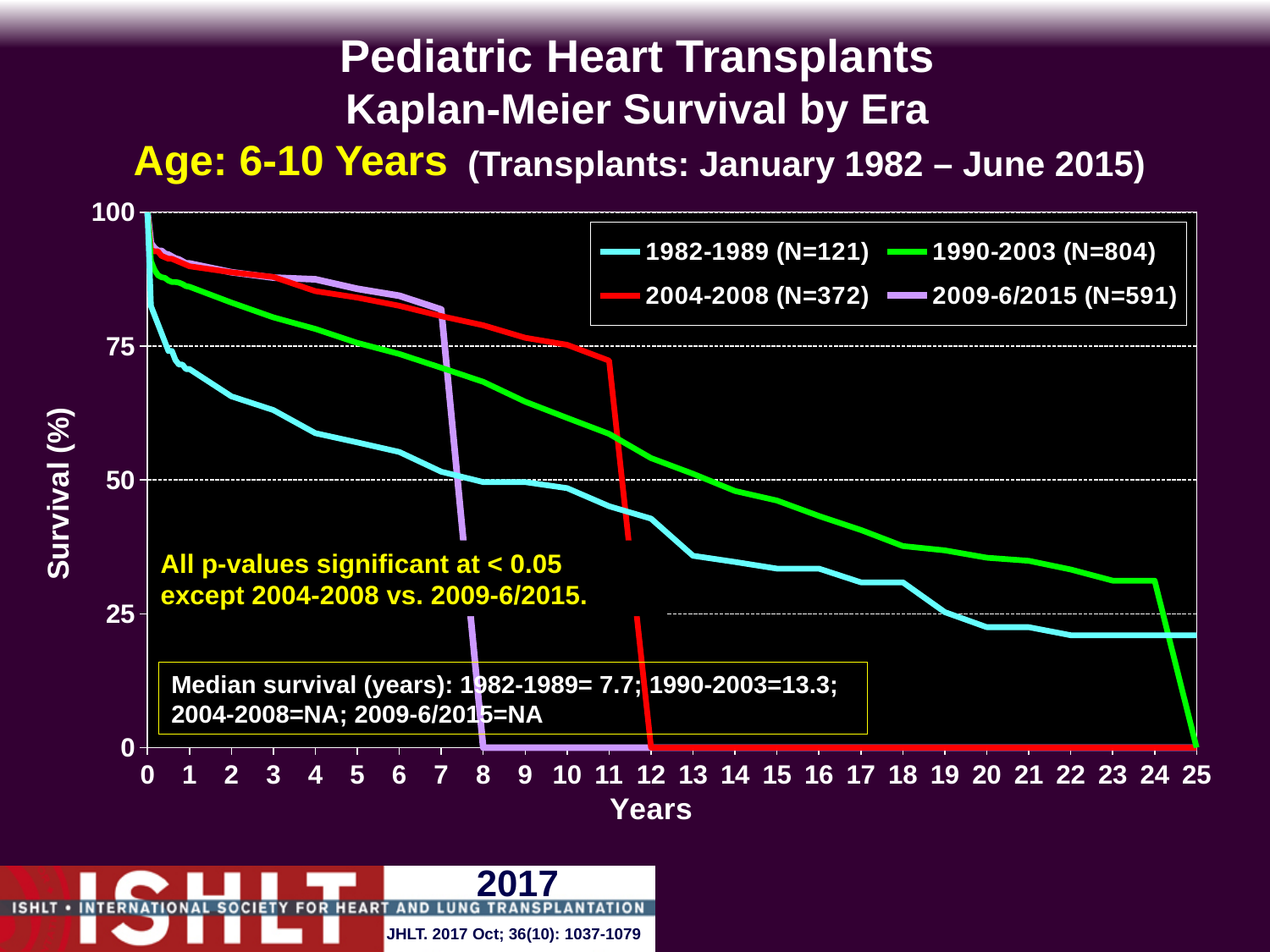
What is the median survival in years for the 1990-2003 era? 13.3 Is the survival for the 1982-1989 era at 5 years greater or less than 50%? greater What is the median survival in years for the 1982-1989 era? 7.7 What kind of chart is shown on the slide? line chart Is the survival for the 1982-1989 era at 20 years greater or less than 25%? less At 5 years, which era has higher survival: 2004-2008 or 1982-1989? 2004-2008 Which era has the largest number of transplants (N) in the legend? 1990-2003 (N=804) What is the label of the y axis? Survival (%) Do the survival curves rise or fall as years since transplant increase? fall What is the N for the 1990-2003 era in the legend? 804 Which era has the smallest number of transplants (N) in the legend? 1982-1989 (N=121) How many eras (series) does the legend list? 4